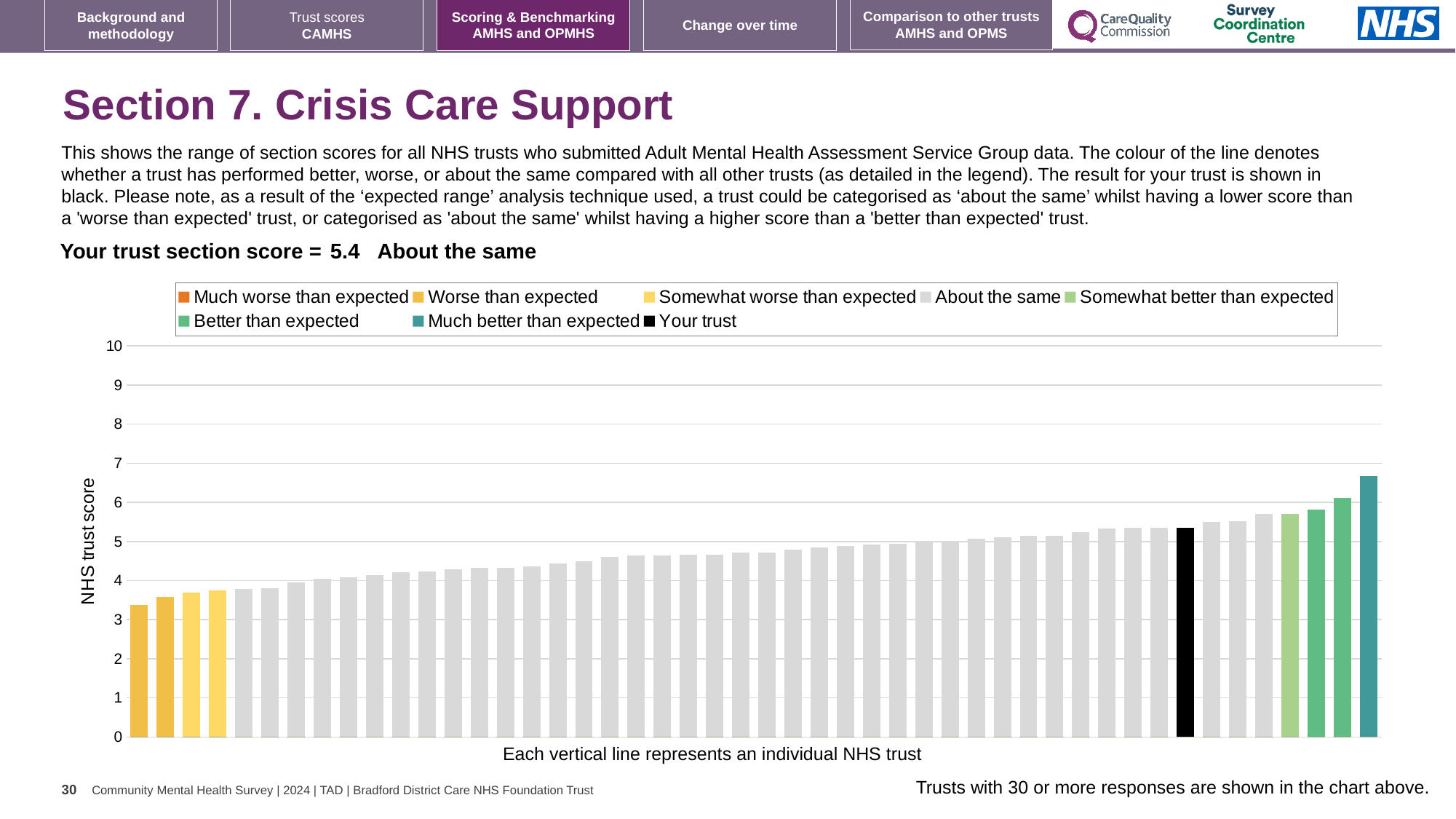
Is the value of the shortest bar greater or less than 4? less What kind of chart is shown on the slide? bar chart Do the bar values rise or fall from left to right along the x axis? rise Is the value for your trust (black bar) greater or less than 5? greater Which is larger: the value of the rightmost teal bar or the value of your trust's black bar? the rightmost teal bar How many bars are coloured teal (much better than expected)? 1 How many entries does the chart legend list? 8 What is the section score for your trust shown on the slide? 5.4 Is the value of the tallest bar greater or less than 6? greater How is your trust categorised compared with other trusts? About the same What is the label on the y axis of the chart? NHS trust score What colour is the bar representing your trust? black